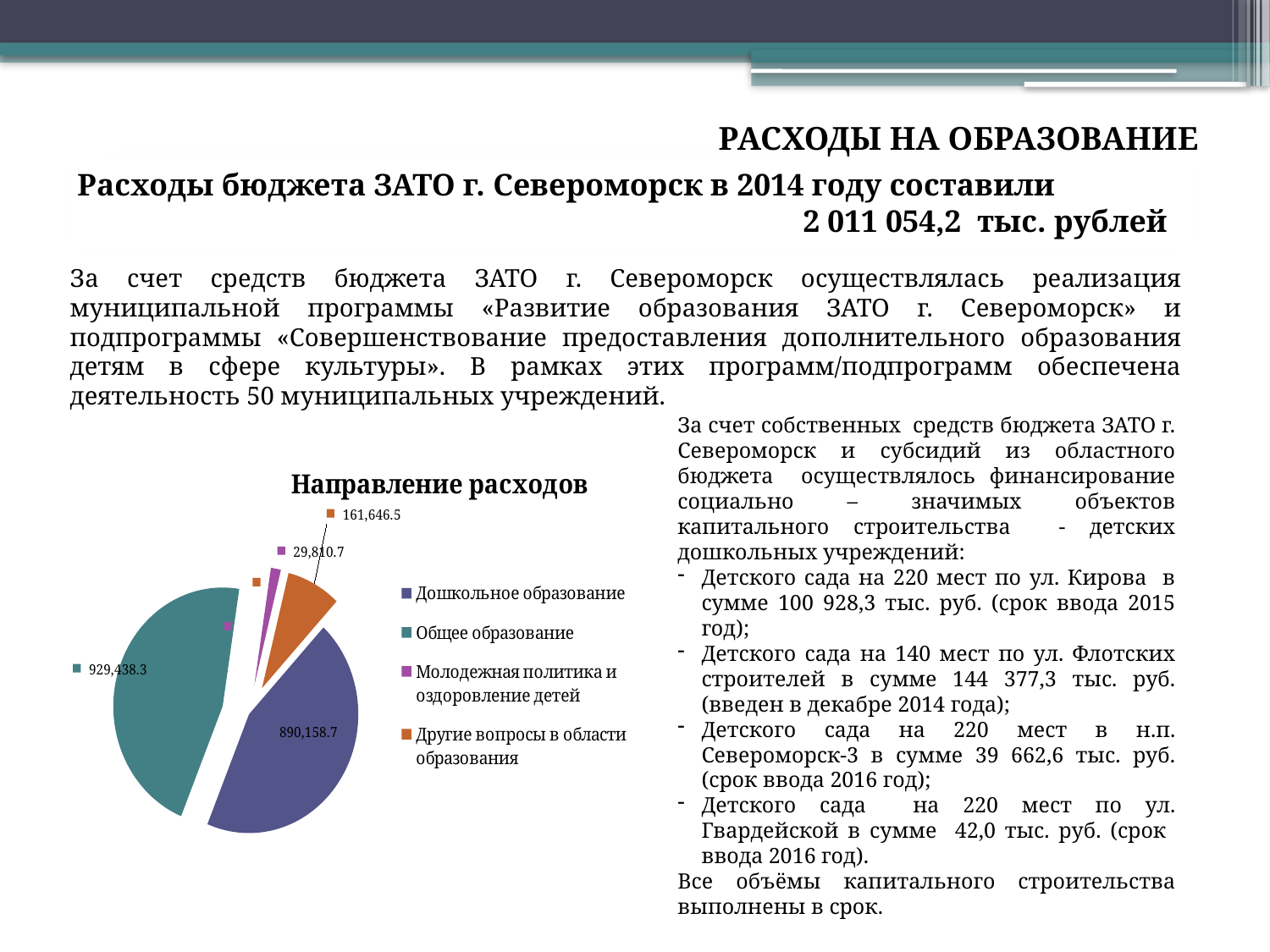
Which category has the smallest slice? Молодежная политика и оздоровление детей What is the value for Молодежная политика и оздоровление детей? 29,810.7 What is the value for Другие вопросы в области образования? 161,646.5 Which legend entry is shown in orange? Другие вопросы в области образования Which is larger, Общее образование or Дошкольное образование? Общее образование What is the value for Общее образование? 929,438.3 What is the value for Дошкольное образование? 890,158.7 What type of chart is shown on the slide? Pie chart How many slices does the pie chart have? 4 Which category has the largest slice? Общее образование What is the title of the chart? Направление расходов What is the difference between Общее образование and Дошкольное образование? 39,279.6